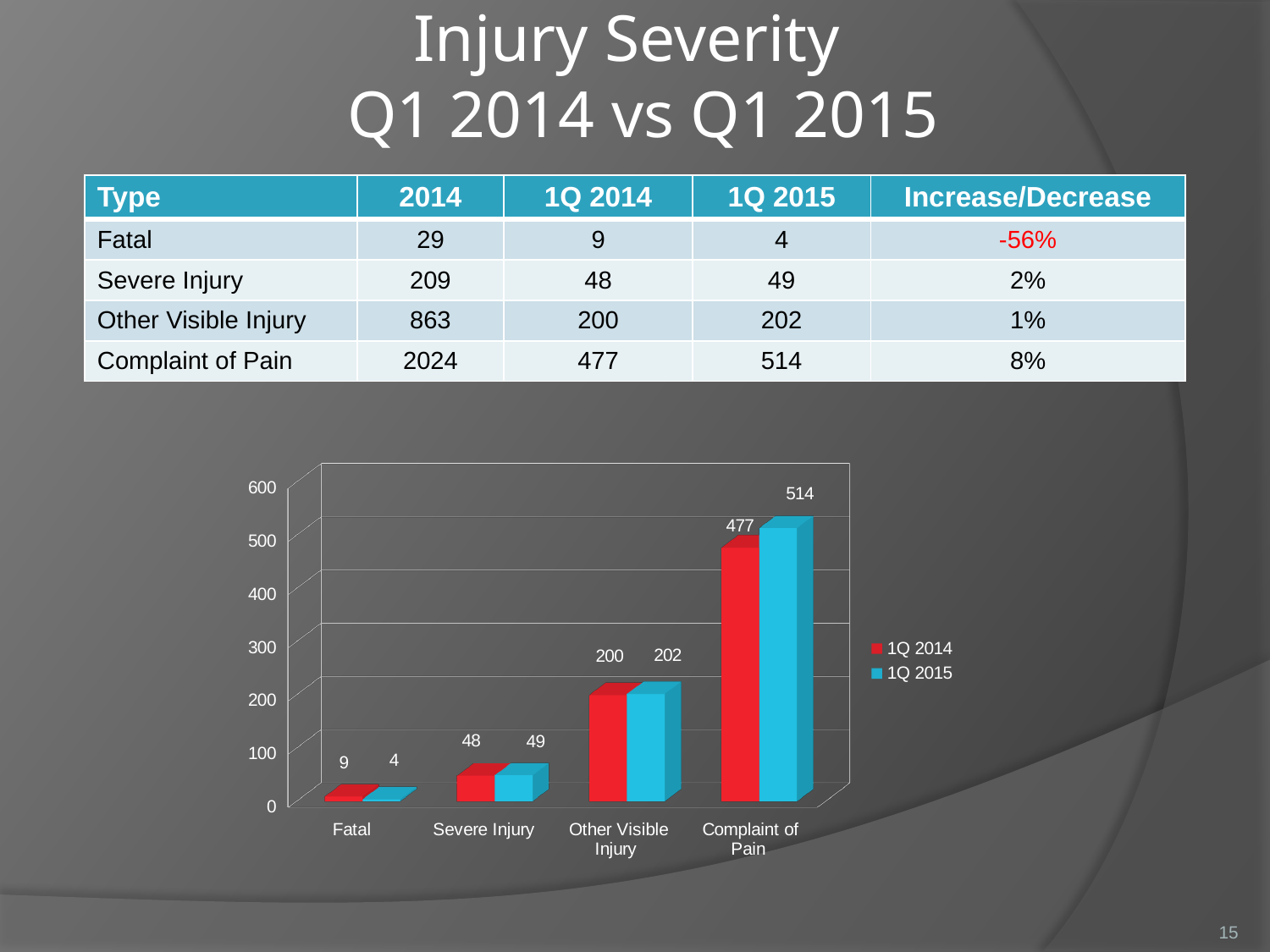
How many categories are shown on the x axis of the chart? 4 Which category has the highest 1Q 2015 value in the chart? Complaint of Pain Which colour represents the 1Q 2015 series in the chart? blue Which is larger for Fatal: the 1Q 2014 value or the 1Q 2015 value? 1Q 2014 What is the 1Q 2015 value for Complaint of Pain in the chart? 514 What is the difference between the 1Q 2015 and 1Q 2014 values for Complaint of Pain? 37 Is the 1Q 2014 value for Other Visible Injury greater or less than 300? less What is the 1Q 2014 value for Fatal in the chart? 9 How many series does the chart legend list? 2 Which category has the lowest 1Q 2014 value in the chart? Fatal What is the 1Q 2014 value for Severe Injury in the chart? 48 What kind of chart is shown on the slide? bar chart